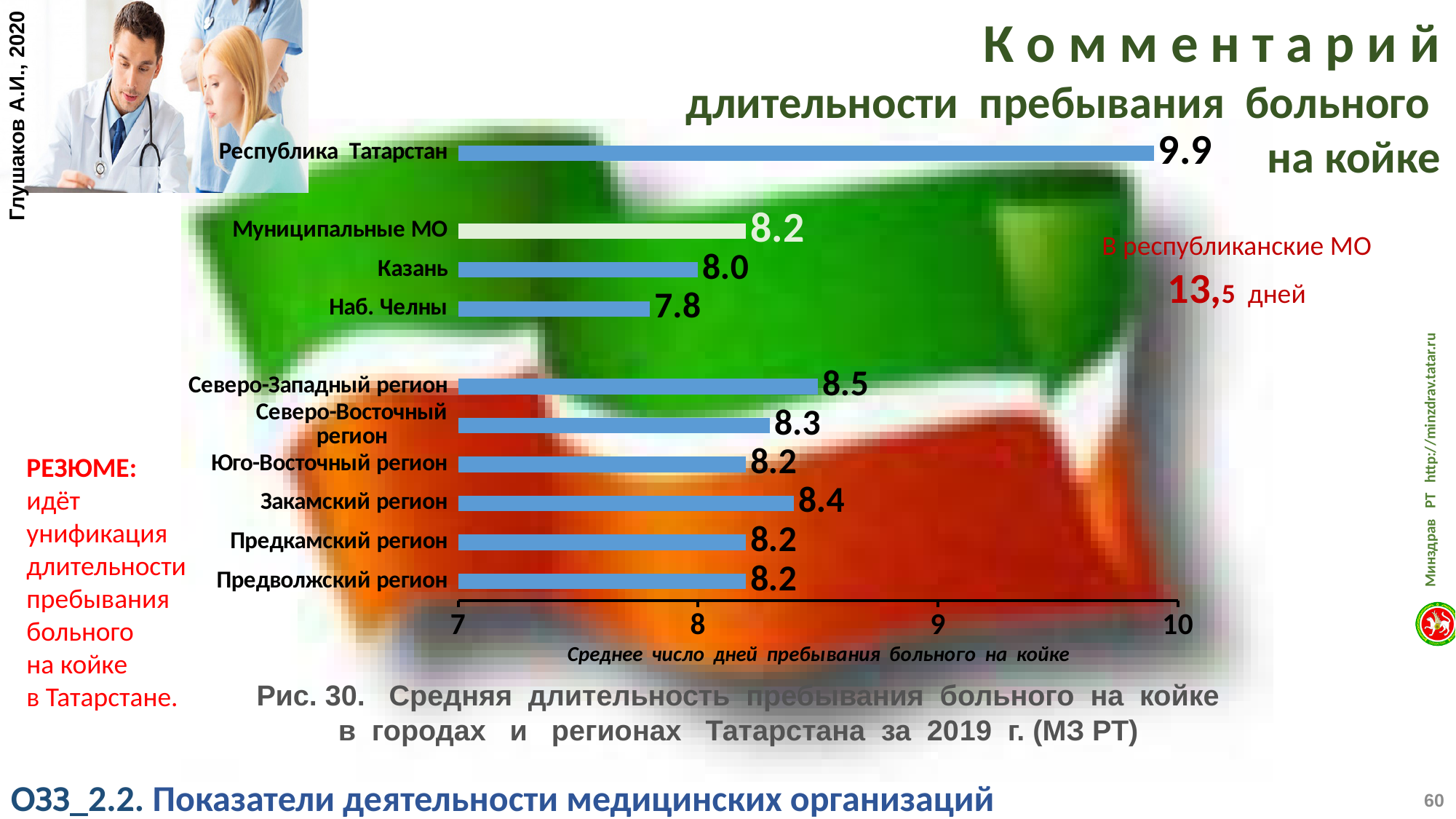
Which category has the highest value? Республика Татарстан Is the value for Казань greater or less than 9? less What kind of chart is shown on the slide? bar chart What is the value for Республика Татарстан? 9.9 What is the value for Наб. Челны? 7.8 What is the value for Северо-Западный регион? 8.5 Which category has the lowest value? Наб. Челны How many categories are plotted in the chart? 10 What is the difference between the values for Республика Татарстан and Наб. Челны? 2.1 What is the title of the horizontal axis of the chart? Среднее число дней пребывания больного на койке Which is larger, the value for Казань or the value for Северо-Восточный регион? Северо-Восточный регион What is the value for Закамский регион? 8.4